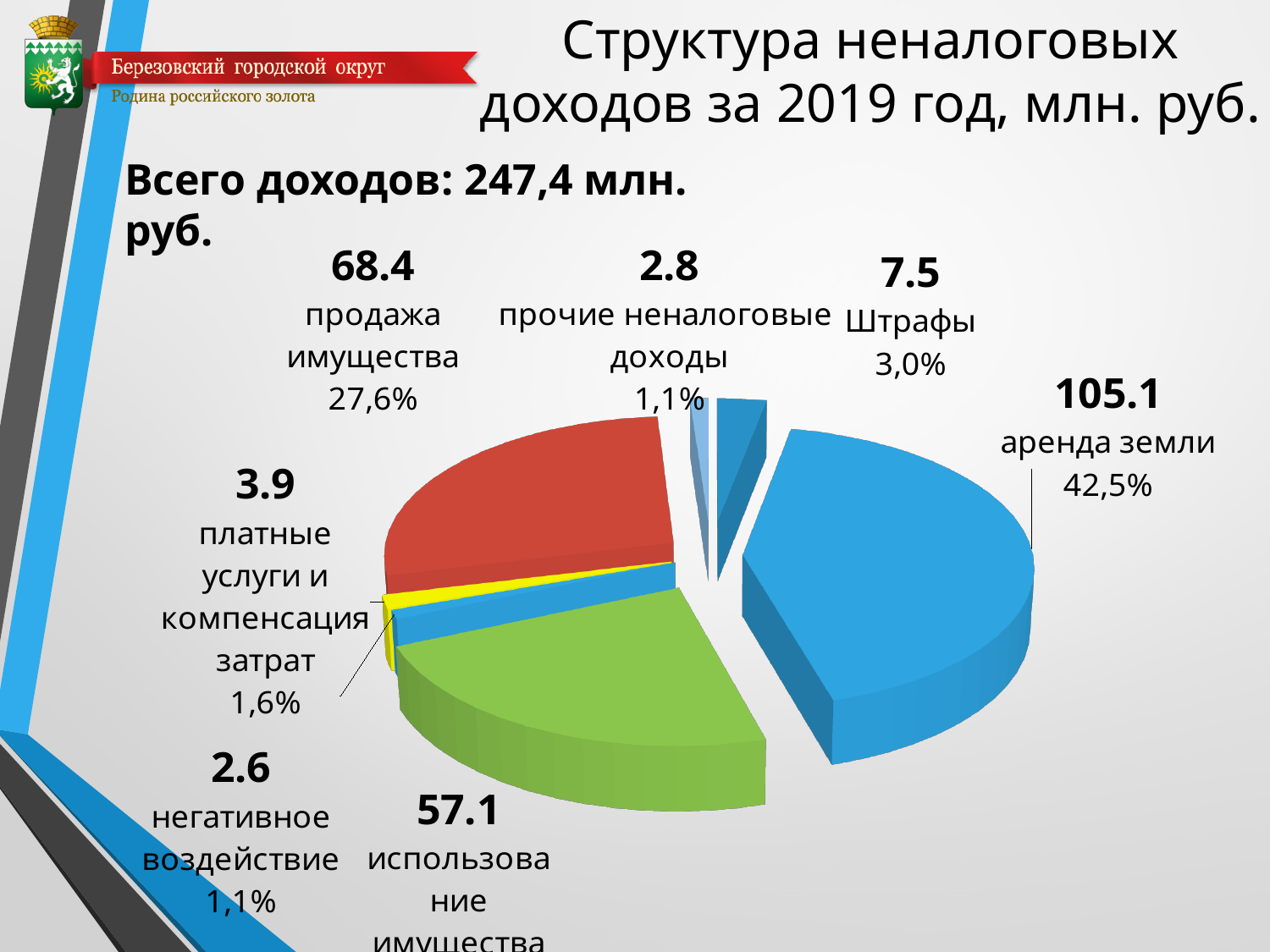
What is the value for Штрафы? 7.5 What is the value for продажа имущества? 68.4 What is the difference between the values for аренда земли and продажа имущества? 36.7 What is the value for аренда земли? 105.1 What share of the pie does платные услуги и компенсация затрат represent? 1,6% What share of the pie does аренда земли represent? 42,5% Which category has the highest value? аренда земли What kind of chart is shown on the slide? pie chart What is the value for использование имущества? 57.1 Which category has the lowest value? негативное воздействие Which is larger, the value for Штрафы or the value for платные услуги и компенсация затрат? Штрафы How many slices does the pie chart have? 7